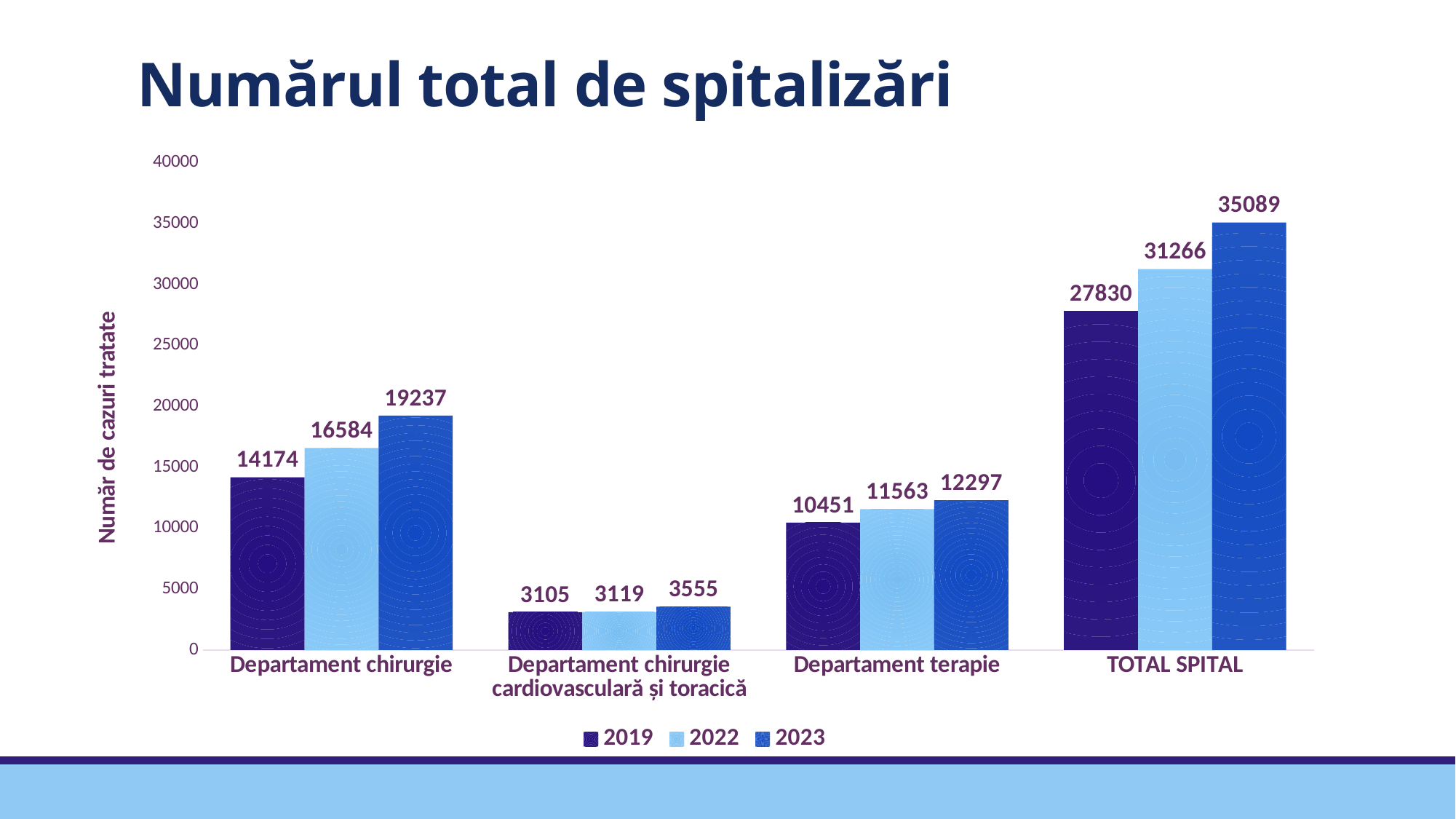
Which category has the lowest value in 2019? Departament chirurgie cardiovasculară și toracică What is the title of the chart? Numărul total de spitalizări What is the value for Departament chirurgie cardiovasculară și toracică in 2023? 3555 What is the value for Departament terapie in 2022? 11563 What is the value for Departament chirurgie in 2019? 14174 How many categories are shown on the x axis? 4 What is the value for TOTAL SPITAL in 2023? 35089 What kind of chart is shown on the slide? bar chart What is the difference between the 2023 and 2019 values for Departament chirurgie? 5063 Which is larger for Departament terapie: the 2019 value or the 2023 value? 2023 Which category has the highest value in 2022? TOTAL SPITAL How many series does the legend list? 3